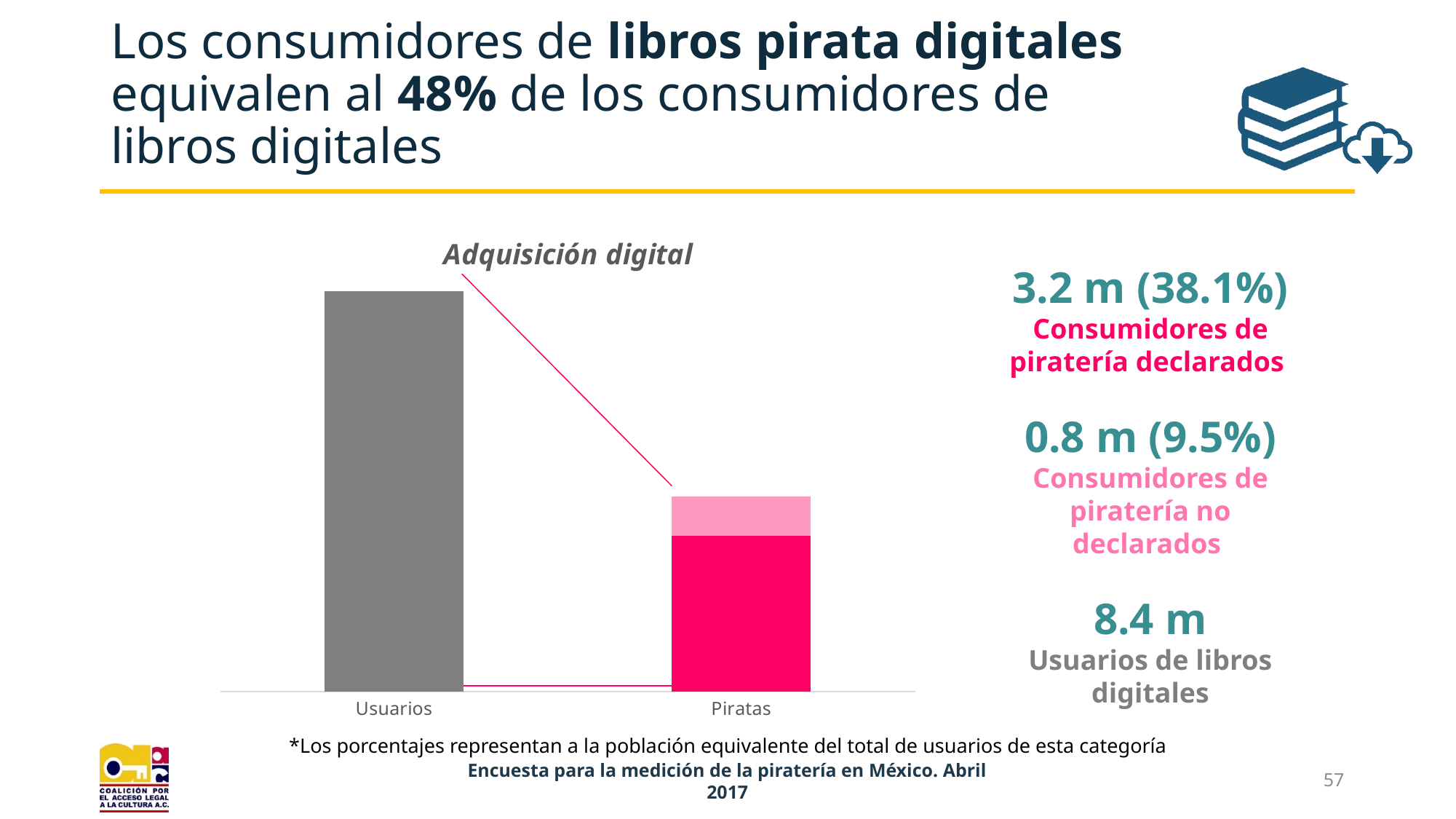
What value does the slide give for Consumidores de piratería declarados? 3.2 m (38.1%) What is the title of the chart? Adquisición digital Do the bar heights rise or fall from Usuarios to Piratas? fall How many segments make up the stacked Piratas bar? 2 What colour is the Usuarios bar? gray According to the slide, how many Usuarios de libros digitales are there? 8.4 m What value does the slide give for Consumidores de piratería no declarados? 0.8 m (9.5%) How many categories are shown on the x axis of the "Adquisición digital" chart? 2 Which is larger, the number of Consumidores de piratería declarados or no declarados? declarados Which category has the shorter bar in the "Adquisición digital" chart? Piratas What kind of chart is shown under the title "Adquisición digital"? bar chart Which category has the taller bar in the "Adquisición digital" chart, Usuarios or Piratas? Usuarios